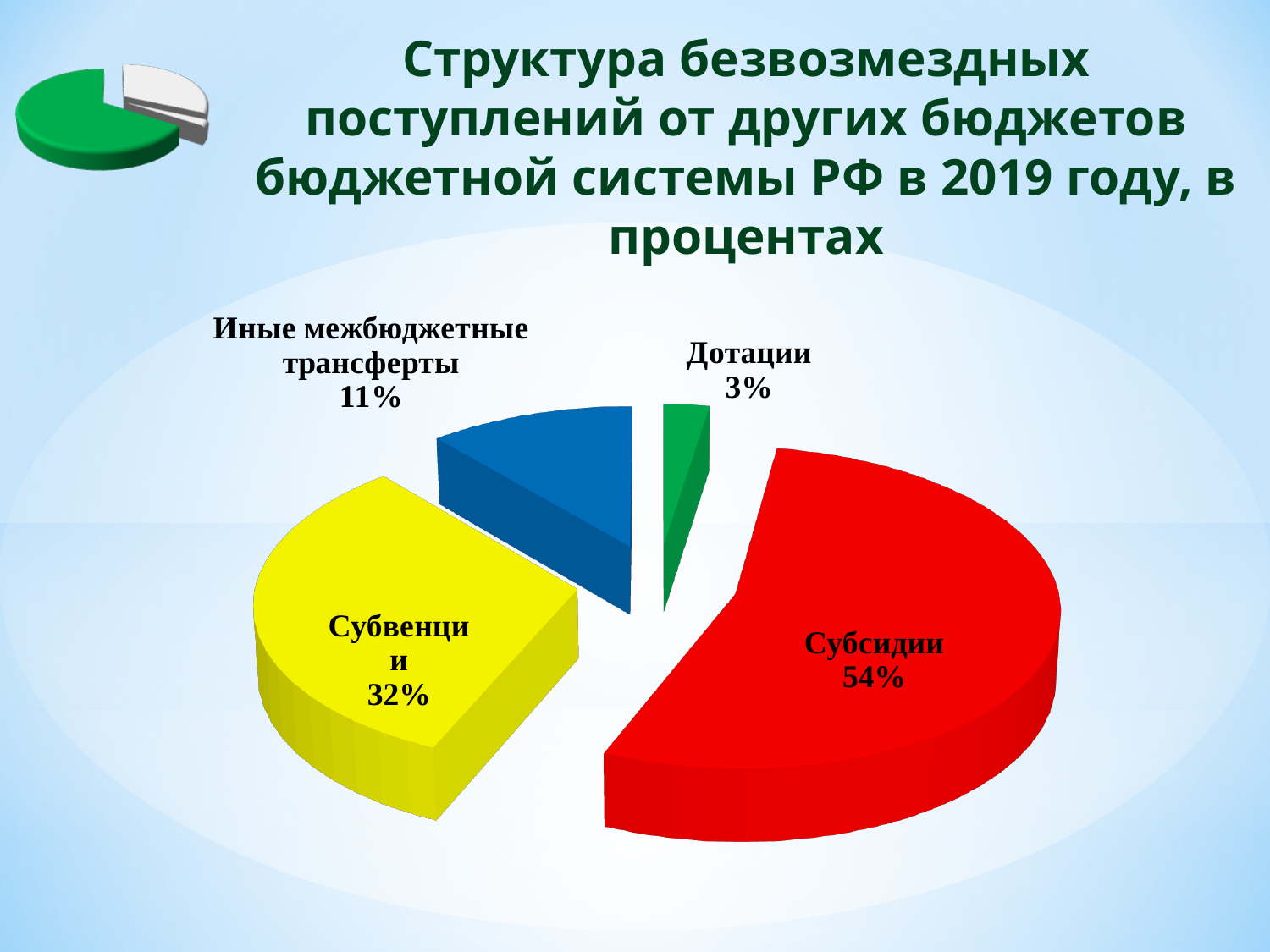
What is the difference in percentage points between Субсидии and Субвенции? 22 What share of the pie does Субсидии have? 54% Which is larger, the share for Иные межбюджетные трансферты or the share for Дотации? Иные межбюджетные трансферты What share of the pie does Дотации have? 3% Which category has the smallest share of the pie? Дотации How many slices does the pie chart have? 4 What share of the pie does Иные межбюджетные трансферты have? 11% What colour is the slice for Дотации? Green Which category has the largest share of the pie? Субсидии What colour is the slice for Субвенции? Yellow What share of the pie does Субвенции have? 32% What kind of chart is shown on the slide? Pie chart